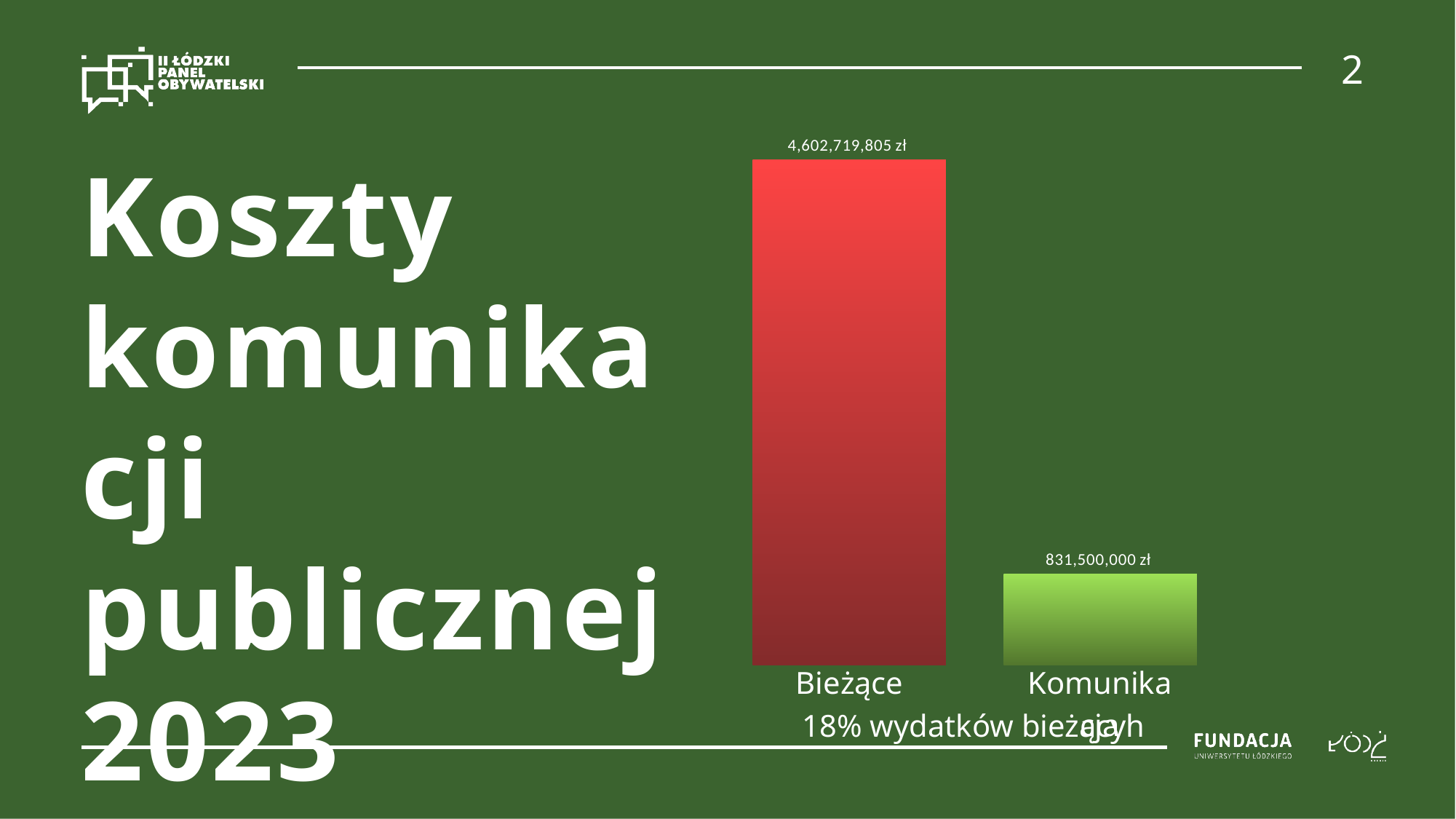
How many bars are plotted in the chart? 2 Which category has the lowest value? Komunikacja What is the difference between the Bieżące value and the Komunikacja value? 3,771,219,805 zł What colour is the Bieżące bar? Red What value is shown for the Komunikacja (green) bar? 831,500,000 zł What value is shown for the Bieżące bar? 4,602,719,805 zł What kind of chart is shown on the slide? Bar chart What percentage of current expenditure (wydatków bieżących) does the text under the chart state? 18% Which is larger, the value for Bieżące or the value for Komunikacja? Bieżące Which category has the highest value? Bieżące